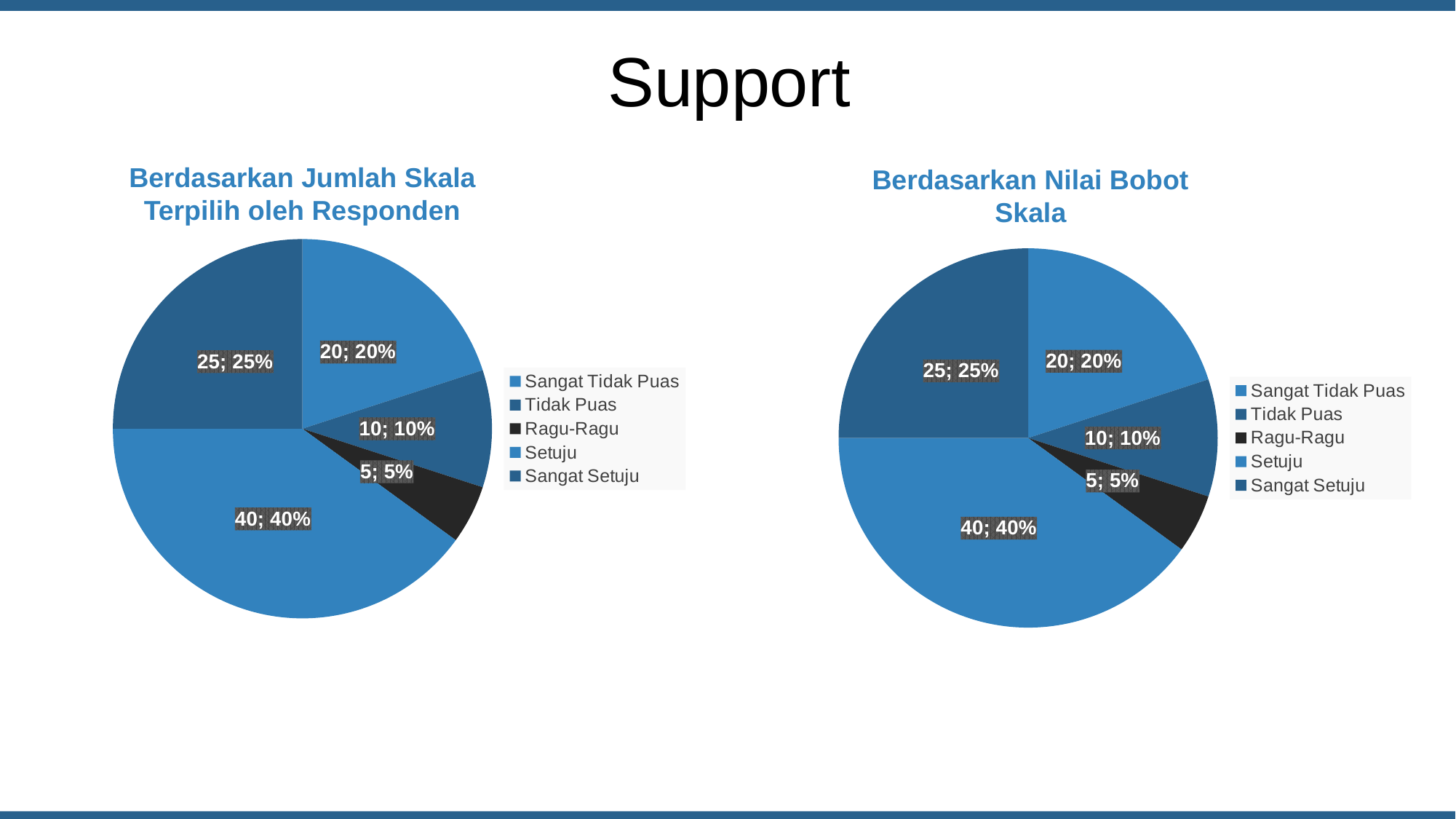
In the left chart, what share of the pie does the Sangat Setuju slice represent? 25% What is the title of the chart on the left side of the slide? Berdasarkan Jumlah Skala Terpilih oleh Responden How many entries does the legend of the right chart list? 5 In the chart titled "Berdasarkan Jumlah Skala Terpilih oleh Responden", what is the data label shown on the Setuju slice? 40; 40% In the left chart, what is the difference between the Sangat Setuju value and the Tidak Puas value? 15 In the right chart, which is larger, the Sangat Tidak Puas slice or the Sangat Setuju slice? Sangat Setuju In the left chart, which category has the largest slice? Setuju In the right chart, what share of the pie does the Tidak Puas slice represent? 10% How many slices does the chart titled "Berdasarkan Jumlah Skala Terpilih oleh Responden" have? 5 What type of chart is the chart titled "Berdasarkan Nilai Bobot Skala"? Pie chart In the right chart, which category has the smallest slice? Ragu-Ragu In the chart titled "Berdasarkan Nilai Bobot Skala", what is the data label shown on the Ragu-Ragu slice? 5; 5%